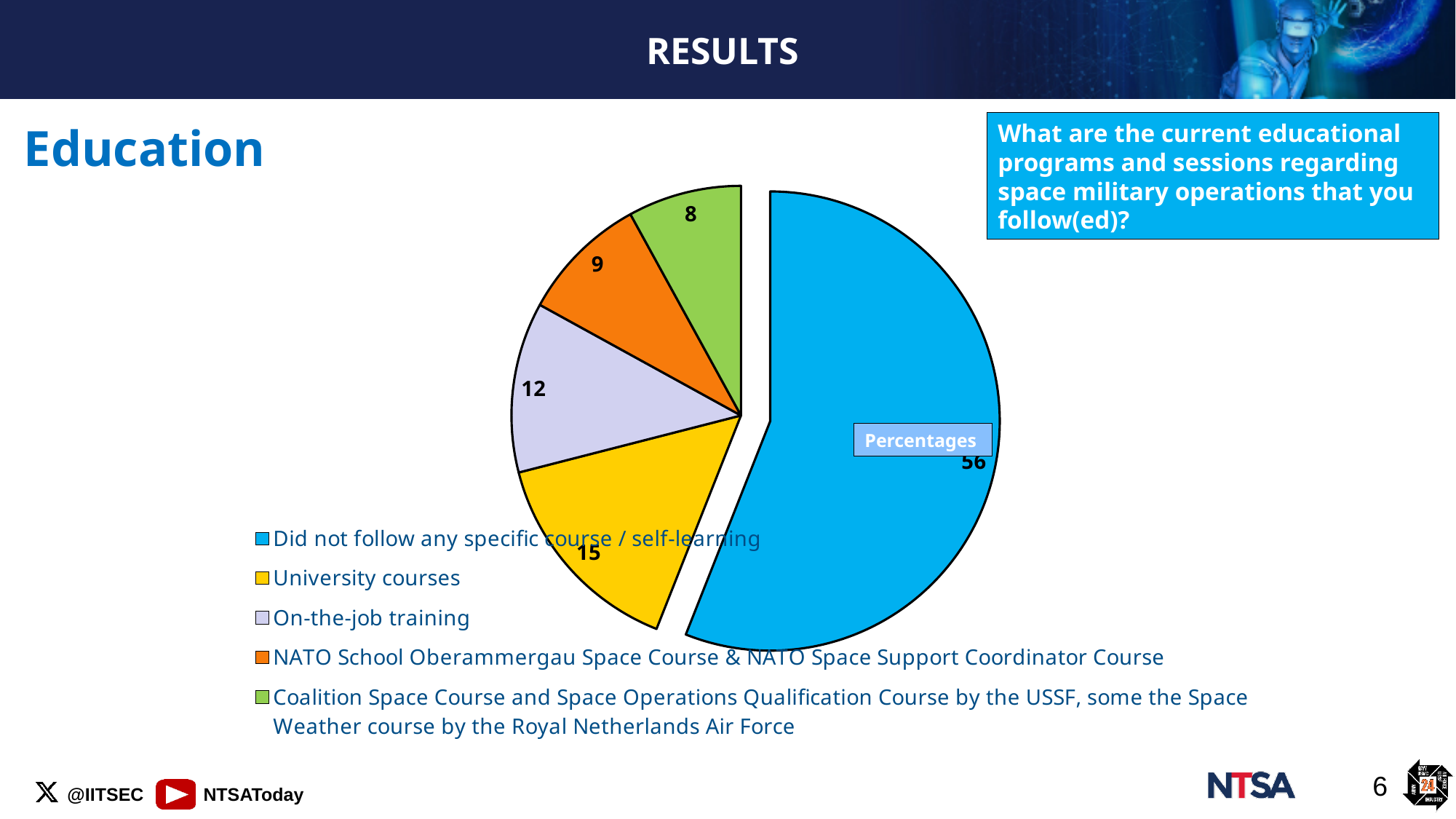
What is the value for "University courses"? 15 What is the difference between the values for "Did not follow any specific course / self-learning" and "University courses"? 41 What is the name of the data series shown on the pie chart? Percentages How many slices does the pie chart have? 5 What is the value for "Did not follow any specific course / self-learning"? 56 What is the value for "NATO School Oberammergau Space Course & NATO Space Support Coordinator Course"? 9 What is the value for "On-the-job training"? 12 Which category has the smallest slice of the pie? Coalition Space Course and Space Operations Qualification Course by the USSF, some the Space Weather course by the Royal Netherlands Air Force What share of the pie does the "Did not follow any specific course / self-learning" slice represent? 56% Which is larger, the value for "On-the-job training" or the value for "University courses"? University courses Which category has the largest slice of the pie? Did not follow any specific course / self-learning What kind of chart is shown on the slide? Pie chart